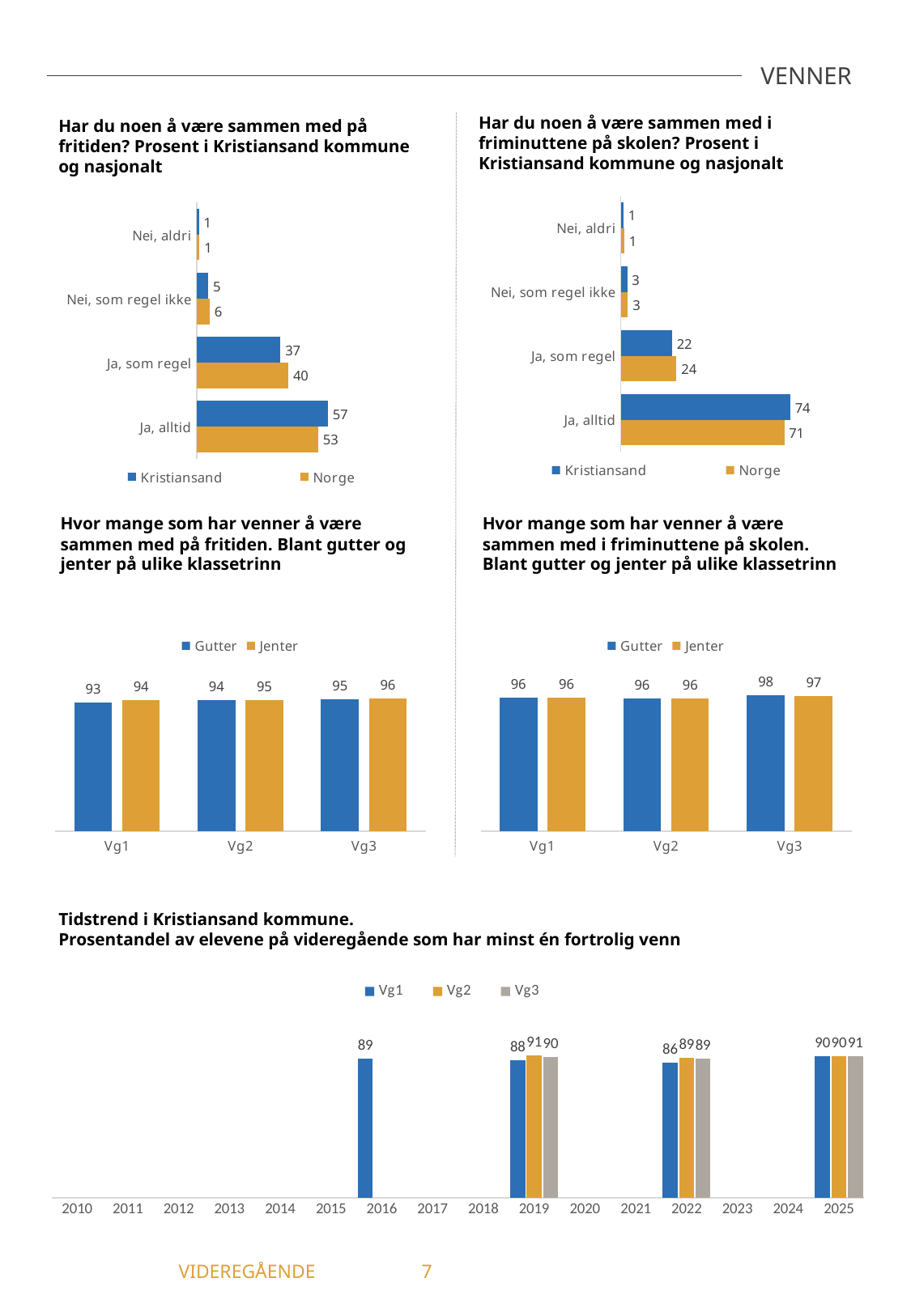
How many series does the legend list in the top-left chart 'Har du noen å være sammen med på fritiden?'? 2 In the top-right chart 'Har du noen å være sammen med i friminuttene på skolen?', what is the Norge value for 'Ja, som regel'? 24 In the top-left chart 'Har du noen å være sammen med på fritiden?', what is the Kristiansand value for 'Ja, alltid'? 57 In the middle-right chart 'Hvor mange som har venner å være sammen med i friminuttene på skolen', what is the Gutter value for Vg3? 98 How many categories are shown on the x axis of the middle-right chart 'Hvor mange som har venner å være sammen med i friminuttene på skolen'? 3 In the bottom chart 'Tidstrend i Kristiansand kommune', what is the Vg1 value for 2022? 86 In the middle-left chart 'Hvor mange som har venner å være sammen med på fritiden', do the Gutter values rise or fall from Vg1 to Vg3? rise In the top-right chart 'Har du noen å være sammen med i friminuttene på skolen?', which category has the highest Kristiansand value? Ja, alltid What kind of chart is the bottom chart 'Tidstrend i Kristiansand kommune'? bar chart In the top-left chart 'Har du noen å være sammen med på fritiden?', what is the difference between the Norge and Kristiansand values for 'Ja, som regel'? 3 In the top-right chart 'Har du noen å være sammen med i friminuttene på skolen?', which is larger for 'Ja, alltid': Kristiansand or Norge? Kristiansand In the middle-left chart 'Hvor mange som har venner å være sammen med på fritiden', what is the Jenter value for Vg2? 95